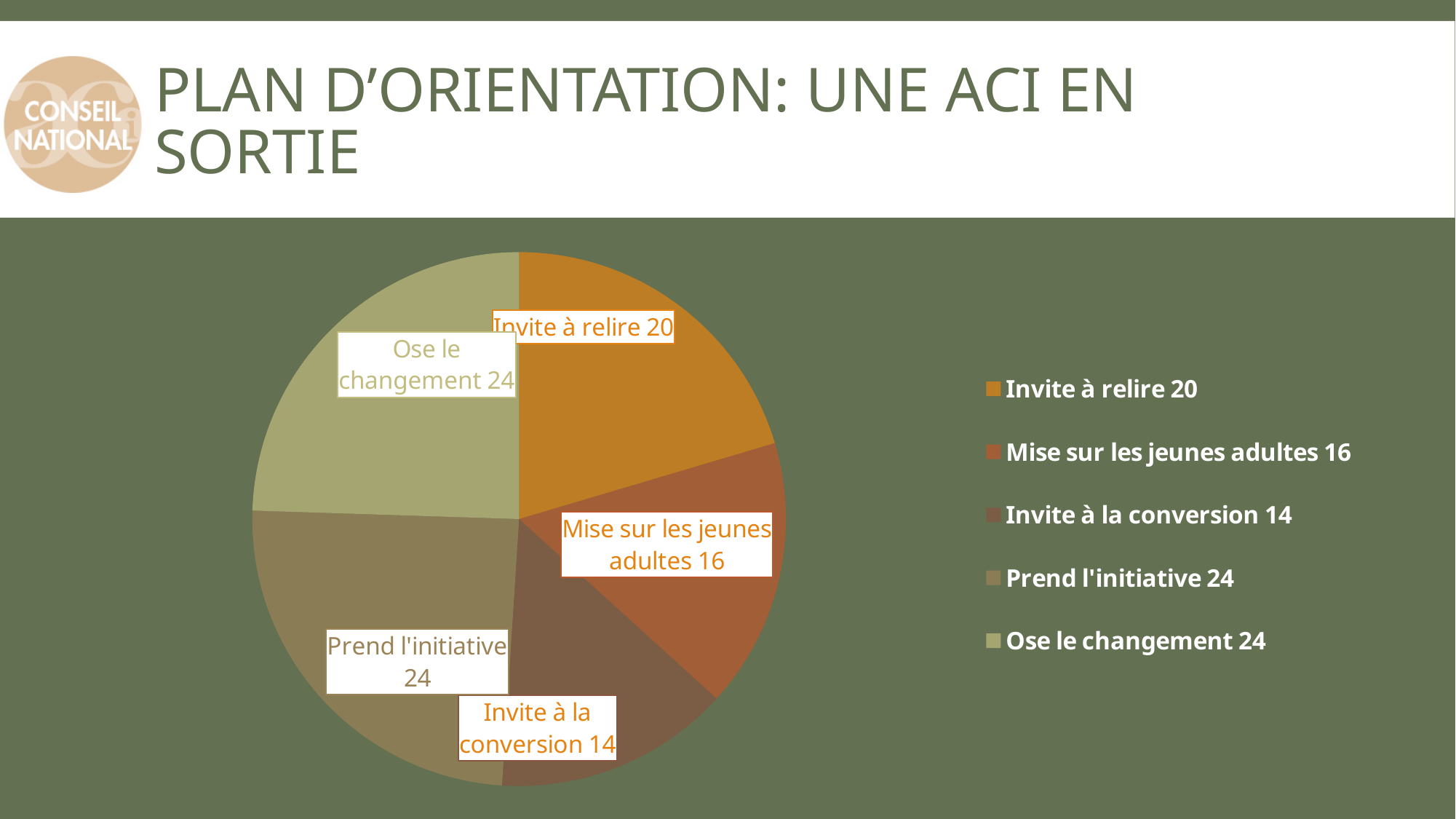
What is the value for "Mise sur les jeunes adultes"? 16 What is the value for "Prend l'initiative"? 24 Which category has the lowest value in the pie chart? Invite à la conversion How many entries does the legend list? 5 Which is larger, the value for "Invite à relire" or the value for "Mise sur les jeunes adultes"? Invite à relire What kind of chart is shown on the slide? pie chart How many slices does the pie chart have? 5 What is the value for "Invite à relire"? 20 What is the difference between the values for "Ose le changement" and "Invite à relire"? 4 What is the difference between the values for "Prend l'initiative" and "Invite à la conversion"? 10 What is the total of all the values shown in the pie chart? 98 What is the value for "Invite à la conversion"? 14